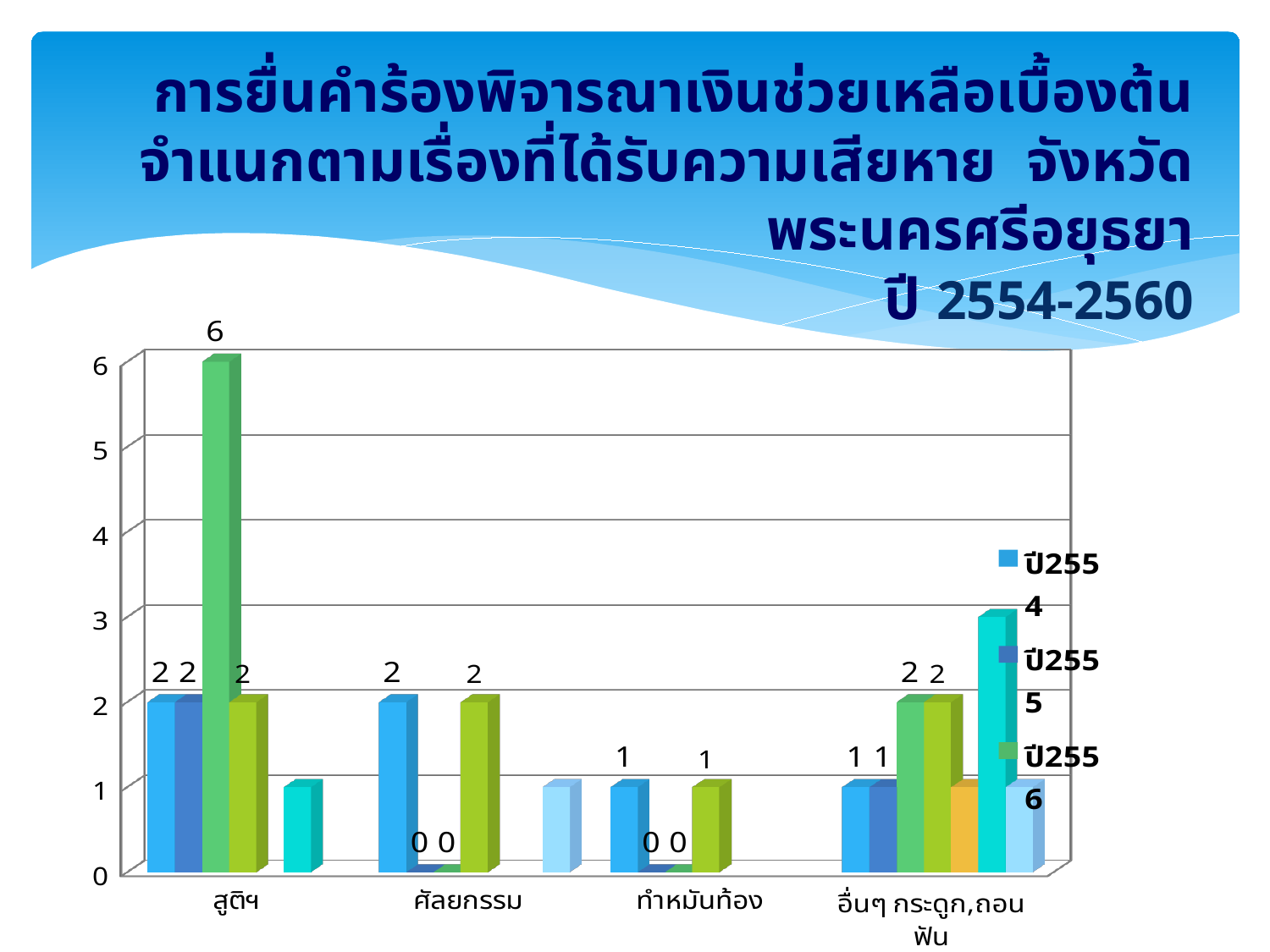
What is the difference between the ปี2556 value and the ปี2554 value for สูติฯ? 4 What is the value for ทำหมันท้อง in the ปี2555 series? 0 What is the value for สูติฯ in the ปี2555 series? 2 What is the value for สูติฯ in the ปี2556 series? 6 Which category has the highest value in the ปี2555 series? สูติฯ What kind of chart is shown on the slide? Bar chart How many categories are shown on the x axis? 4 What is the value for อื่นๆ กระดูก,ถอนฟัน in the ปี2556 series? 2 What is the value for ศัลยกรรม in the ปี2554 series? 2 For สูติฯ, which is larger: the ปี2556 value or the ปี2554 value? ปี2556 Which province is named in the slide title? พระนครศรีอยุธยา Which category has the highest value in the ปี2556 series? สูติฯ